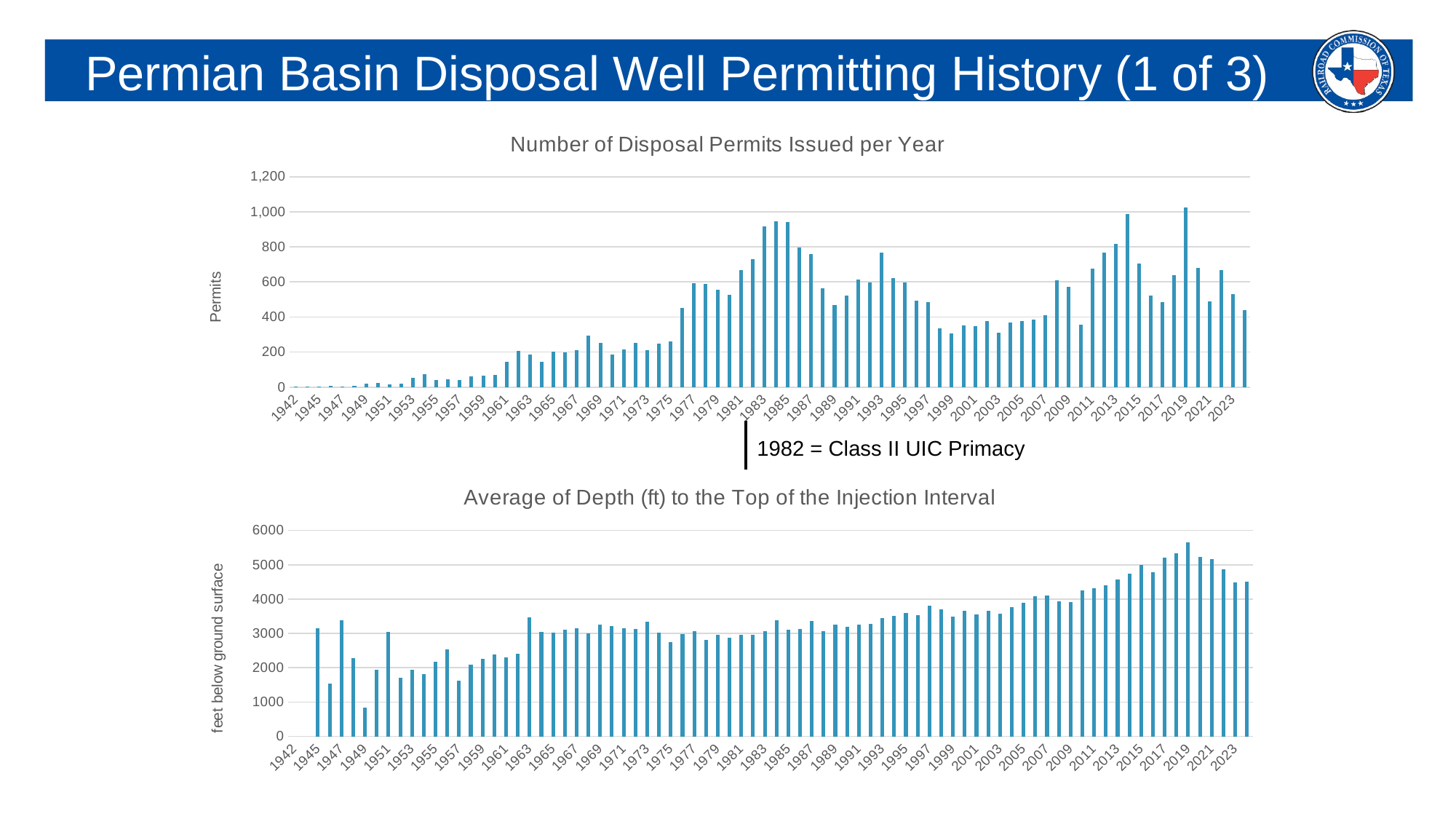
In the bottom chart, 'Average of Depth (ft) to the Top of the Injection Interval', which year has the highest value? 2019 In the bottom chart, 'Average of Depth (ft) to the Top of the Injection Interval', which year has the lowest value? 1949 In the top chart, 'Number of Disposal Permits Issued per Year', is the value for 1942 greater or less than 200? less In the top chart, 'Number of Disposal Permits Issued per Year', is the value for 1999 greater or less than 400? less What event does the annotation below the top chart mark for 1982? Class II UIC Primacy In the top chart, 'Number of Disposal Permits Issued per Year', is the value for 1983 greater or less than 800? greater In the top chart, 'Number of Disposal Permits Issued per Year', which is larger, the value for 1983 or the value for 1999? 1983 What is the y-axis label of the top chart, 'Number of Disposal Permits Issued per Year'? Permits In the bottom chart, 'Average of Depth (ft) to the Top of the Injection Interval', do the values generally rise or fall from 1990 to 2019? rise What kind of chart is the top chart, 'Number of Disposal Permits Issued per Year'? bar chart